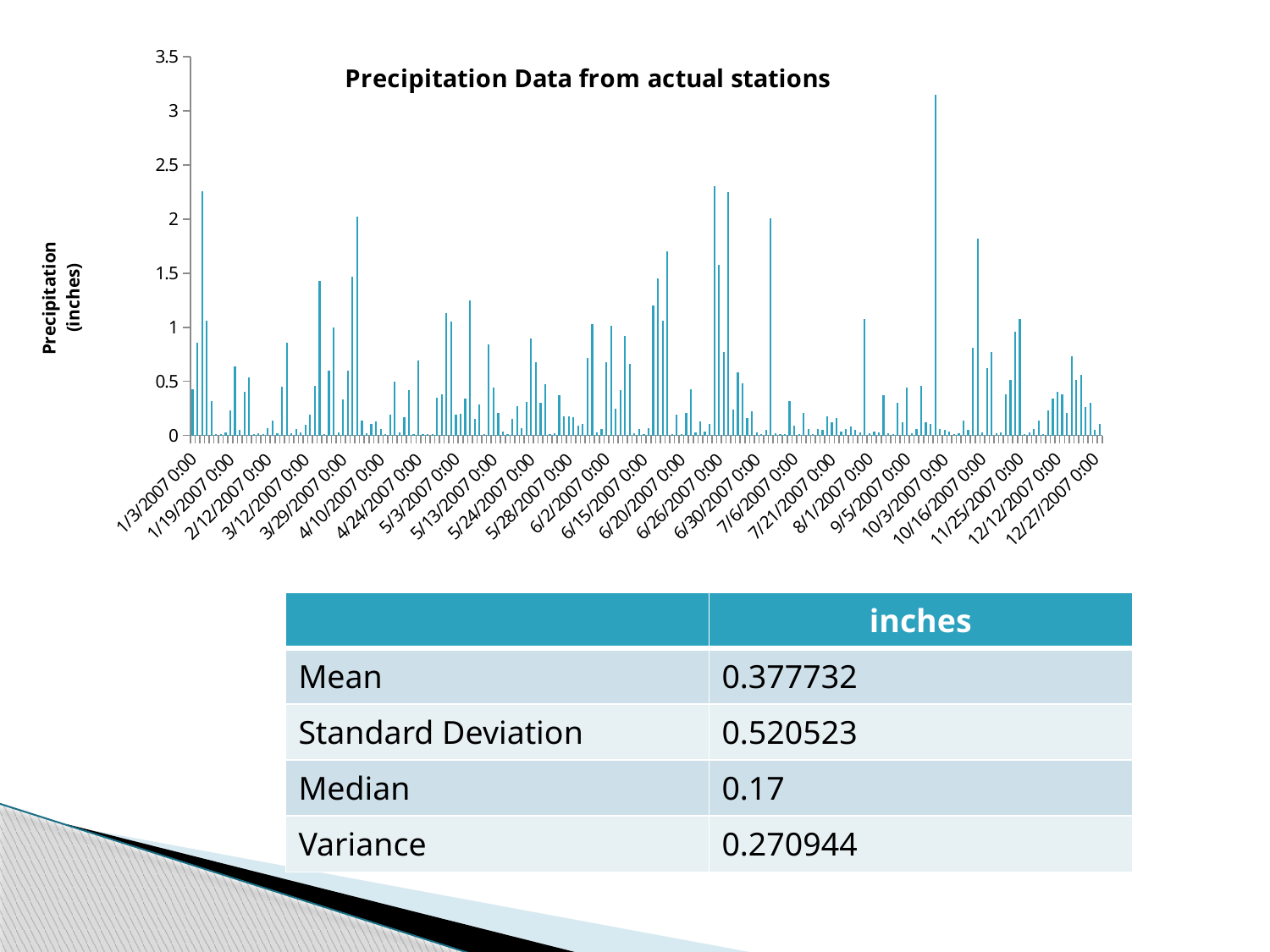
What kind of chart is shown on the slide? bar chart Is the tallest bar in the chart located in the first half or the second half of the x axis? second half What is the label on the vertical axis of the chart? Precipitation (inches) Is the value of the last bar on the right of the chart greater or less than 0.5? less What is the title of the chart? Precipitation Data from actual stations Is the value of the tallest bar in the chart greater or less than 3? greater How many bars in the chart exceed 3 inches? 1 Is the value of the tallest bar in the chart greater or less than 3.5? less